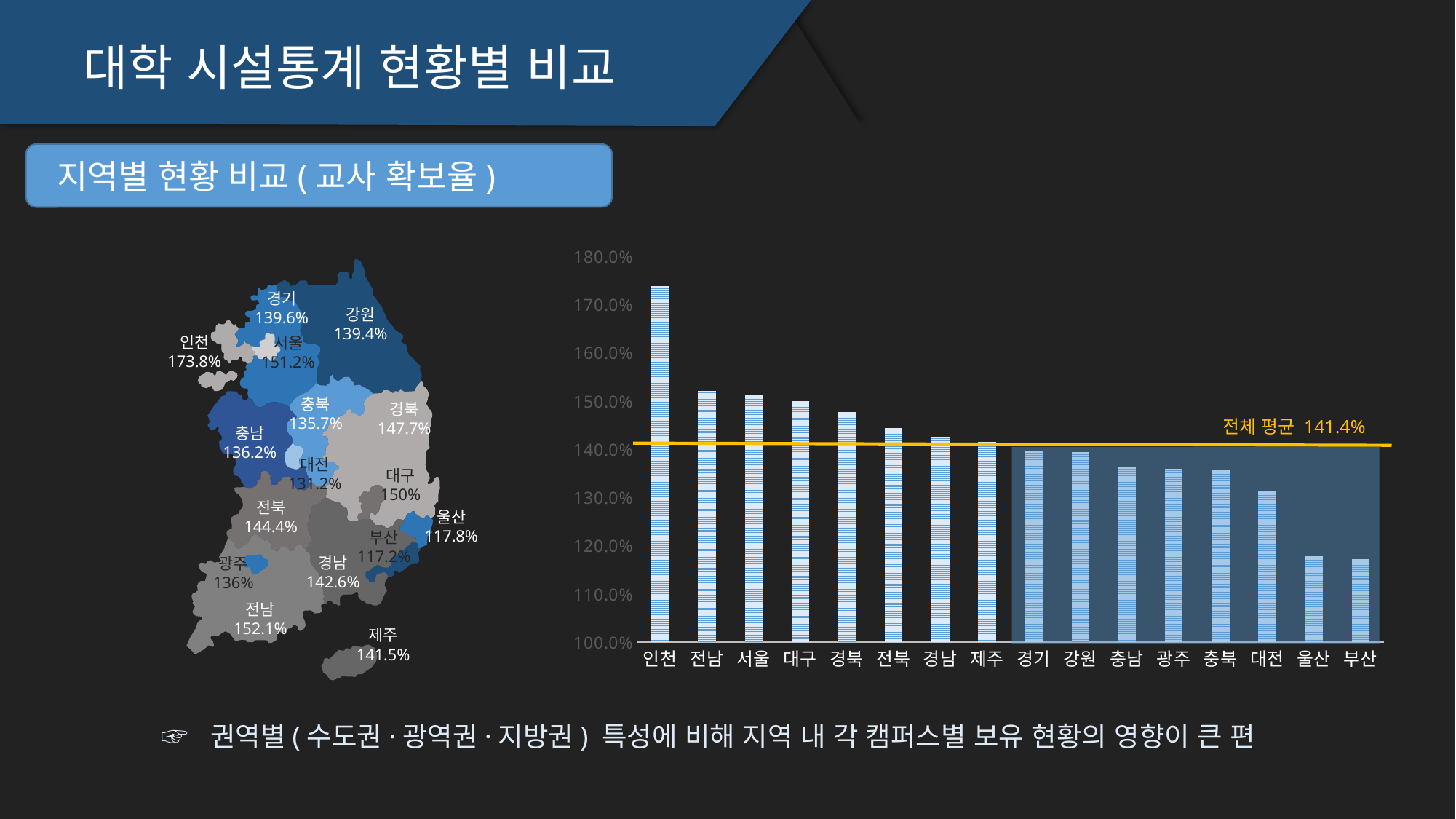
How many regions are plotted along the x axis of the bar chart? 16 In the bar chart, is the value for 경북 greater or less than 140.0%? greater What is the 전체 평균 value marked by the horizontal line on the bar chart? 141.4% What kind of chart is shown on the right side of the slide? bar chart Which region has the highest bar in the bar chart? 인천 What is the 교사 확보율 value printed for 인천 on the map? 173.8% In the bar chart, is the value for 대전 greater or less than 140.0%? less According to the values printed on the map, which region has the lowest 교사 확보율? 부산 Do the bars in the bar chart rise or fall from left to right along the x axis? fall Using the values printed on the map, what is the difference between 인천 (173.8%) and 부산 (117.2%)? 56.6% Which has the larger 교사 확보율, 전북 or 충남? 전북 What is the 교사 확보율 value printed for 전남 on the map? 152.1%